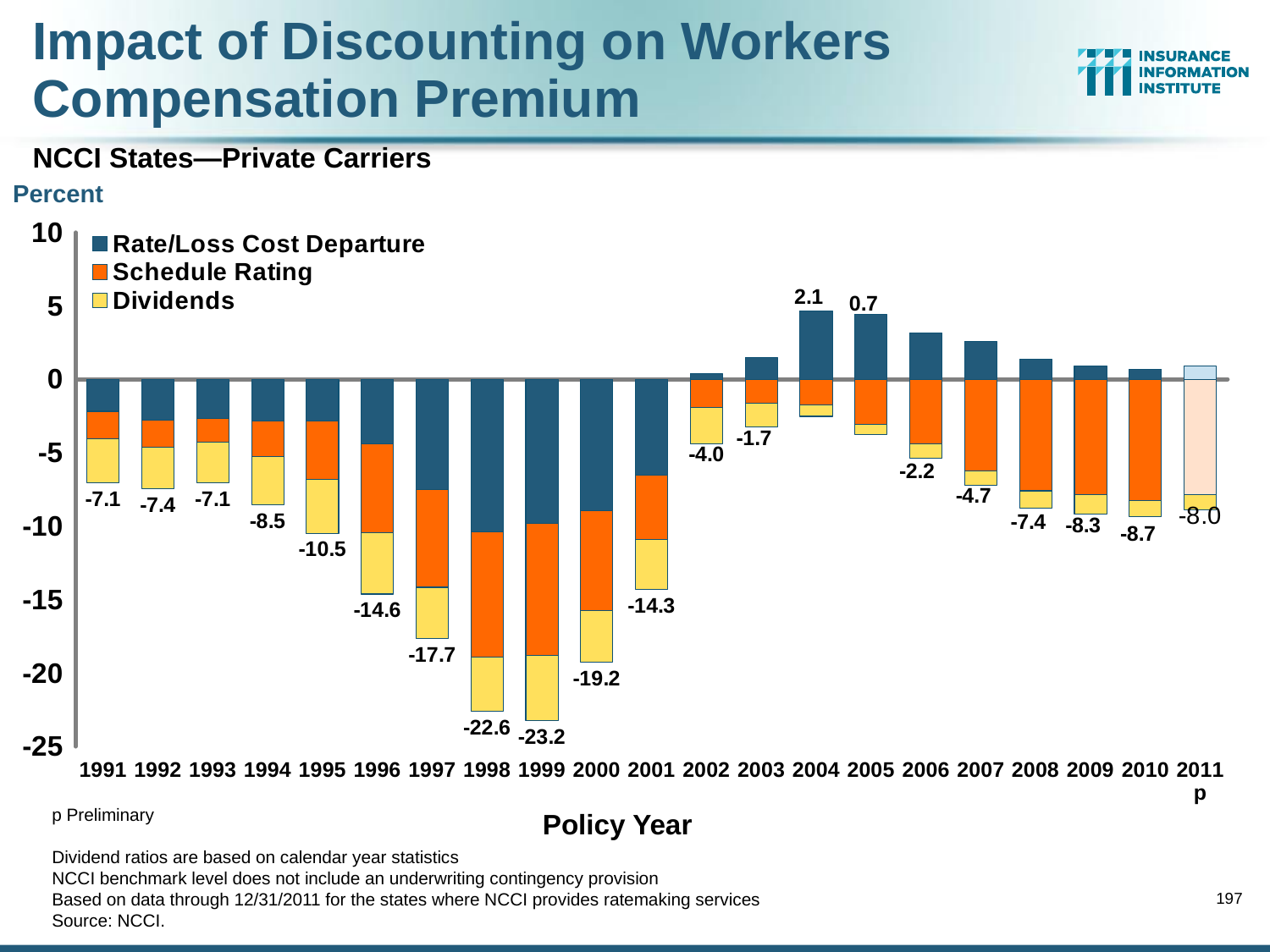
What is the labeled value for policy year 2004? 2.1 Which series is shown in yellow in the legend? Dividends What is the labeled value for policy year 1999? -23.2 Do the labeled values rise or fall from 1991 to 1999? Fall What kind of chart is shown on the slide? Stacked bar chart Which policy year has a larger labeled value, 2005 or 2006? 2005 How many series does the legend list? 3 Which policy year has the highest labeled value? 2004 What is the difference between the labeled values for 1998 and 1999? 0.6 Which policy year has the lowest labeled value? 1999 What is the labeled value for policy year 2011p? -8.0 How many policy years are shown on the x axis? 21